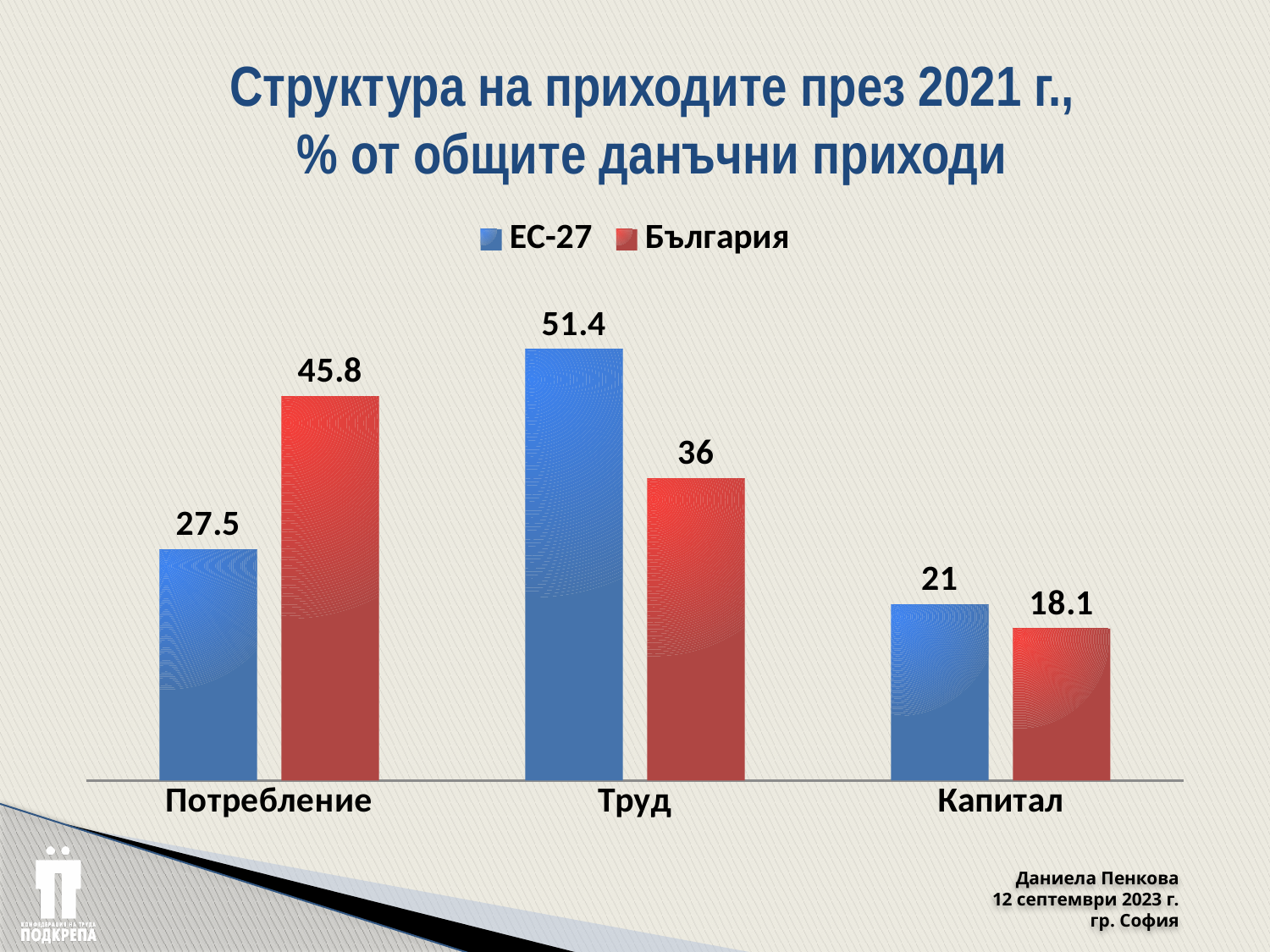
What is the difference between the България and ЕС-27 values in the Потребление category? 18.3 How many categories are shown on the x axis? 3 Which category has the highest value for ЕС-27? Труд Which colour represents the България series? Red What kind of chart is shown on the slide? Bar chart Which category has the lowest value for България? Капитал What is the difference between the ЕС-27 and България values in the Труд category? 15.4 What is the value for ЕС-27 in the Потребление category? 27.5 What is the value for България in the Труд category? 36 How many series does the legend list? 2 In the Капитал category, which series has the larger value, ЕС-27 or България? ЕС-27 What is the value for България in the Капитал category? 18.1